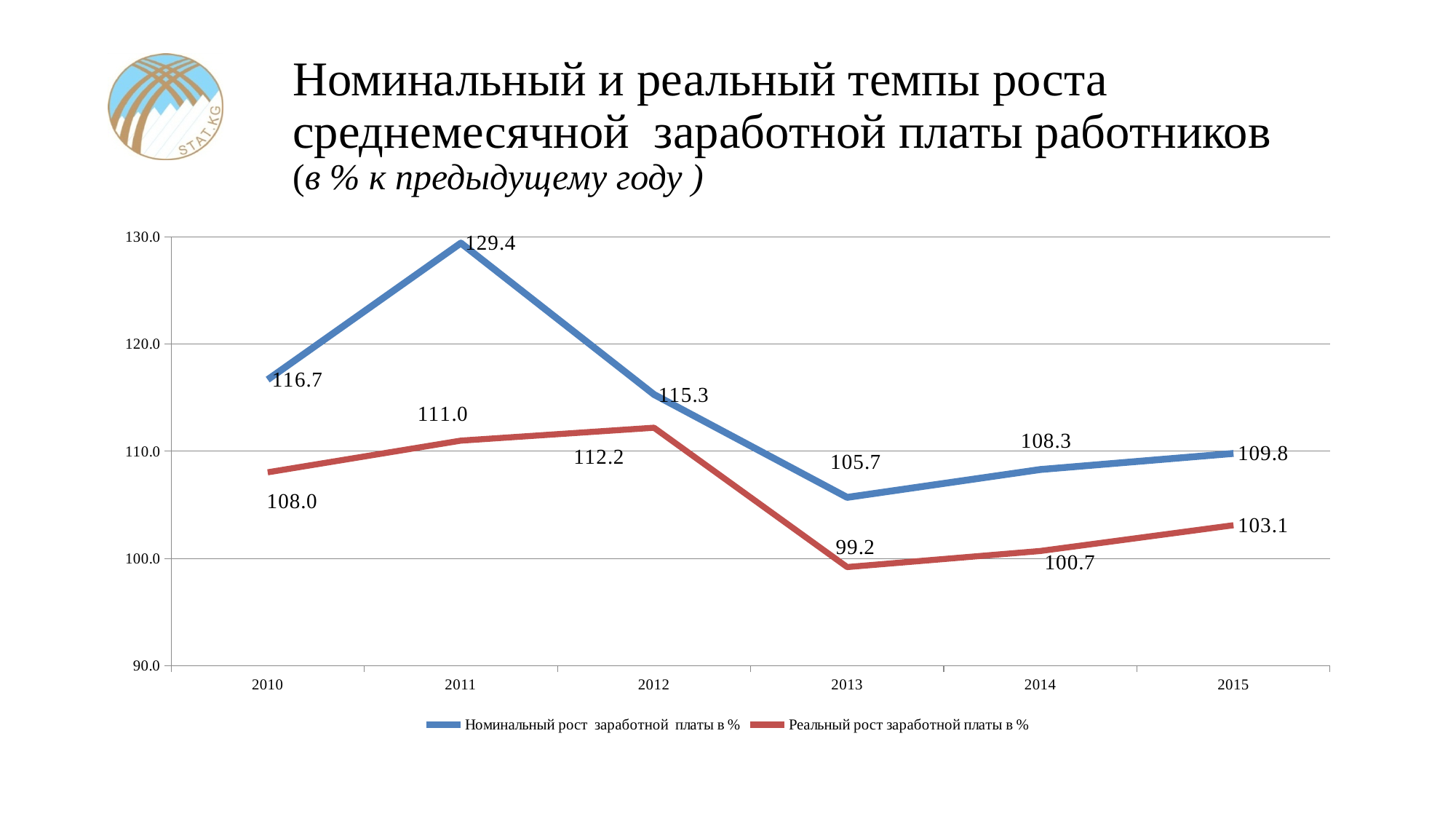
In which year is the real wage growth series at its lowest? 2013 What is the value of the real wage growth series (Реальный рост заработной платы в %) in 2013? 99.2 What is the difference between the nominal and real wage growth values in 2011? 18.4 Which is larger in 2012: the nominal wage growth value or the real wage growth value? Nominal wage growth (115.3) In which year is the nominal wage growth series at its highest? 2011 How many series does the legend list? 2 What is the value of the real wage growth series in 2015? 103.1 Is the real wage growth value in 2013 greater or less than 100.0? less What kind of chart is shown on the slide? Line chart Does the nominal wage growth series rise or fall from 2013 to 2015? Rises How many years are shown on the x axis? 6 What is the value of the nominal wage growth series (Номинальный рост заработной платы в %) in 2011? 129.4